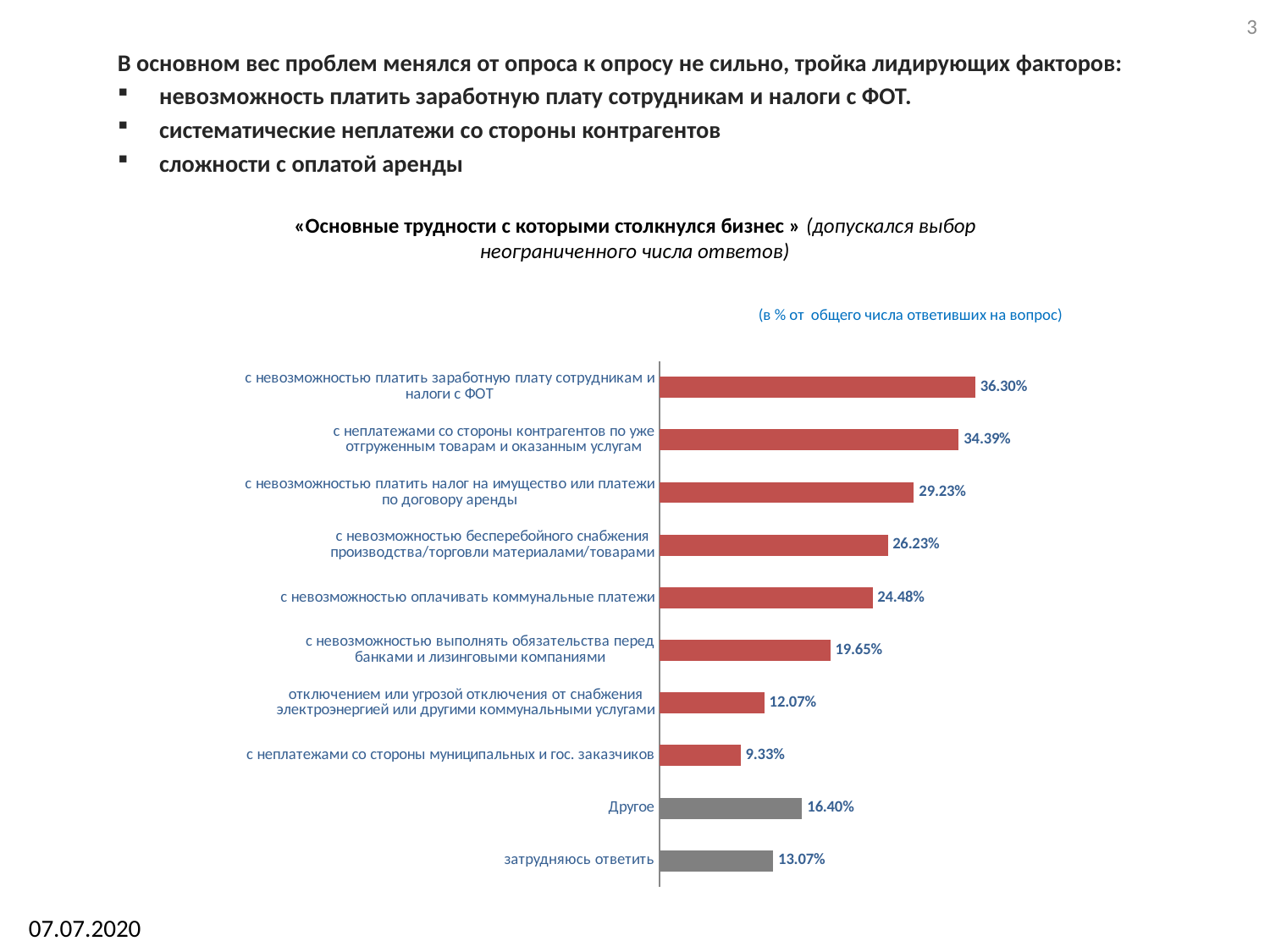
Which category has the lowest value in the chart? с неплатежами со стороны муниципальных и гос. заказчиков What value is shown for «затрудняюсь ответить»? 13.07% Which is larger: the value for «с невозможностью выполнять обязательства перед банками и лизинговыми компаниями» or the value for «Другое»? с невозможностью выполнять обязательства перед банками и лизинговыми компаниями What kind of chart is shown on the slide? bar chart What percentage of respondents reported the difficulty «с невозможностью платить заработную плату сотрудникам и налоги с ФОТ»? 36.30% What is the difference between the values for «с невозможностью платить заработную плату сотрудникам и налоги с ФОТ» and «с неплатежами со стороны контрагентов по уже отгруженным товарам и оказанным услугам»? 1.91% Which two categories are drawn in grey rather than red? Другое and затрудняюсь ответить What value is shown for «Другое»? 16.40% How many categories are shown in the chart? 10 What value is shown for «с невозможностью оплачивать коммунальные платежи»? 24.48% Which category has the highest value in the chart? с невозможностью платить заработную плату сотрудникам и налоги с ФОТ What is the difference between the values for «Другое» and «затрудняюсь ответить»? 3.33%